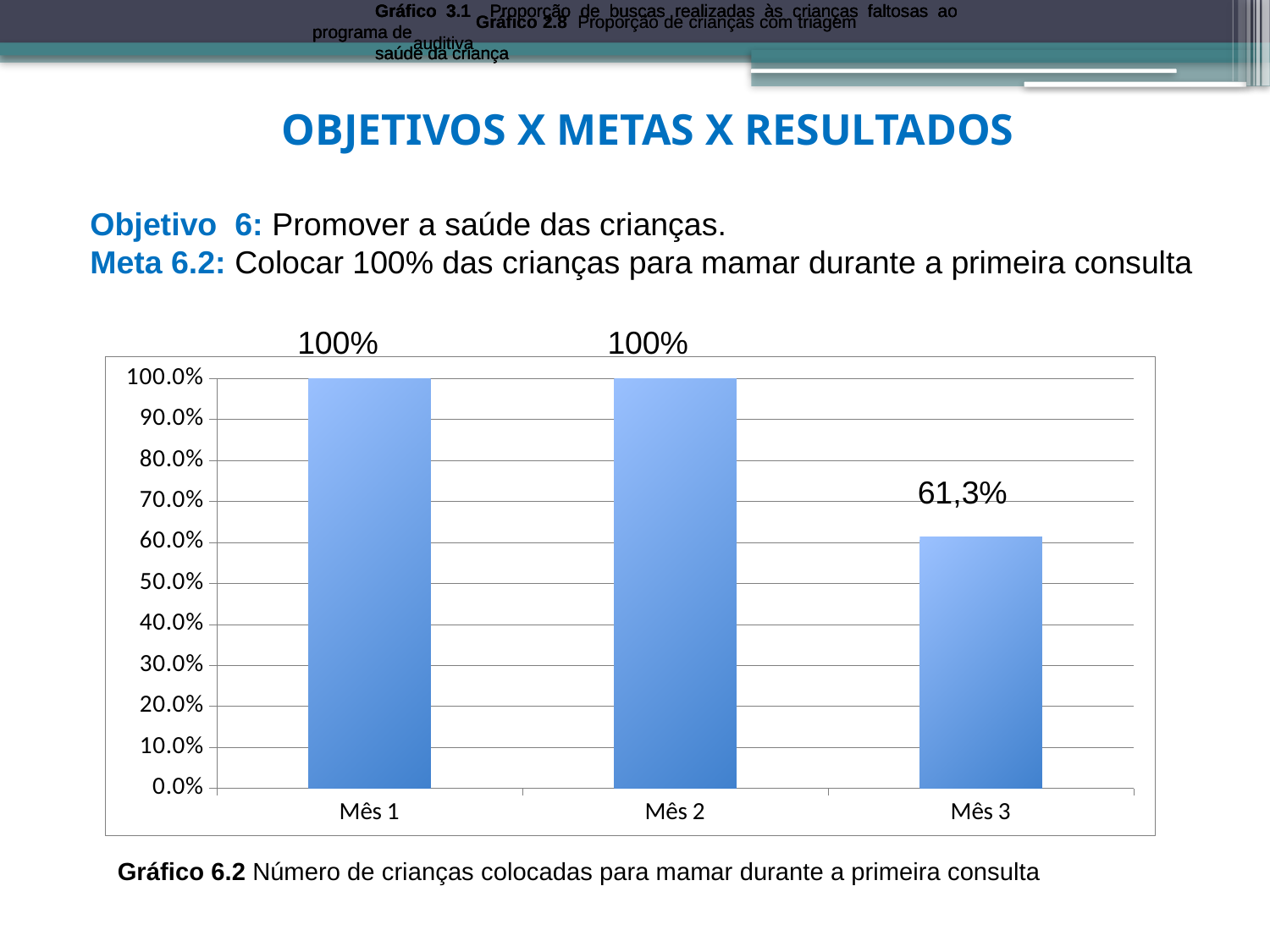
Is the value for Mês 3 greater or less than 50.0%? greater What is the value for Mês 3? 61,3% What kind of chart is shown on the slide? bar chart What is the value for Mês 2? 100% What is the caption of the chart (Gráfico 6.2)? Número de crianças colocadas para mamar durante a primeira consulta What is the highest value shown on the y axis? 100.0% Is the value for Mês 3 greater or less than 70.0%? less What is the value for Mês 1? 100% Which month has the lowest value? Mês 3 Which is larger, the value for Mês 2 or the value for Mês 3? Mês 2 How many categories are shown on the x axis? 3 Do the values rise or fall from Mês 2 to Mês 3? fall